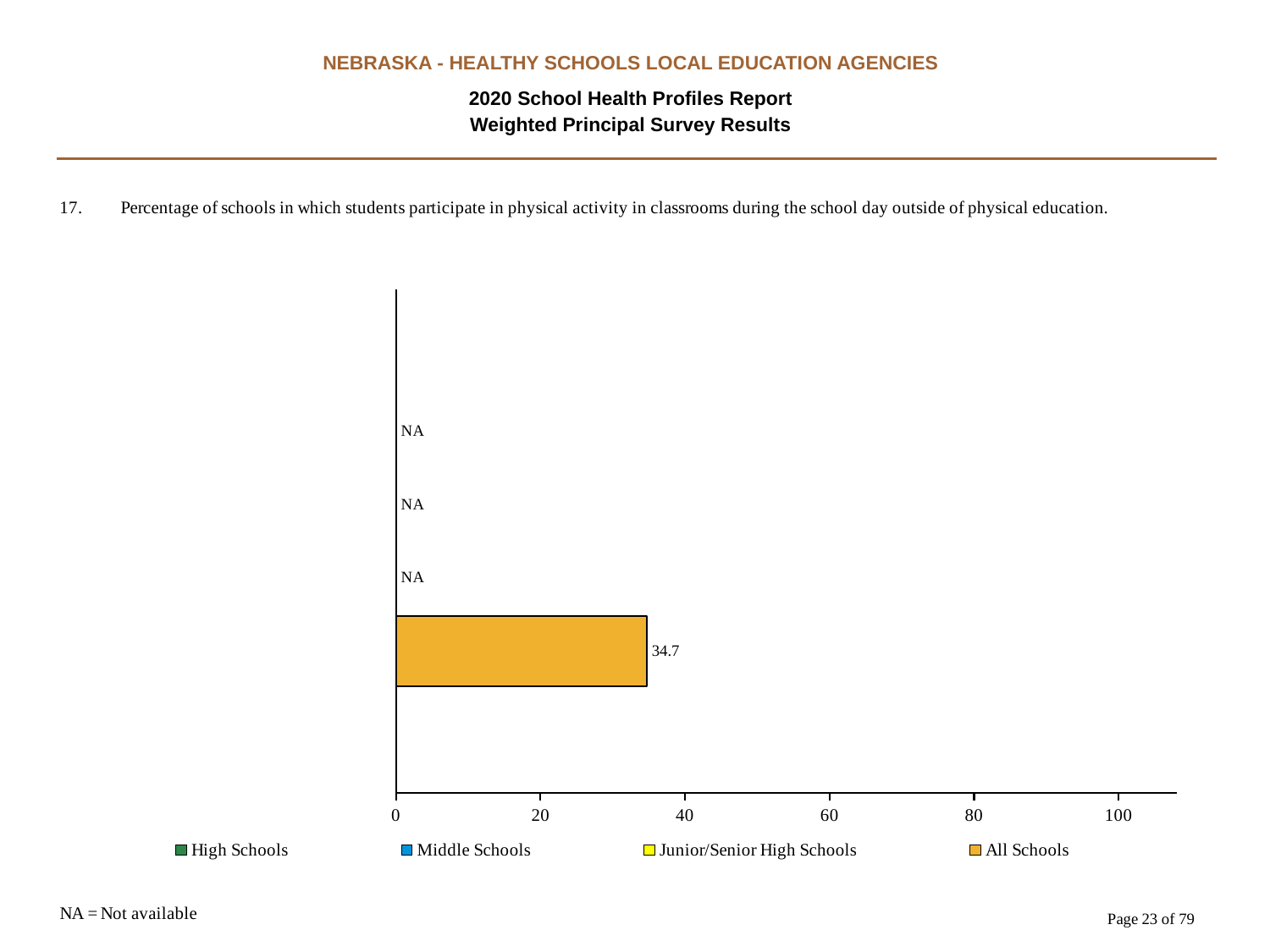
What kind of chart is shown on the slide? bar chart What is shown for Middle Schools on the chart? NA What is the value for All Schools? 34.7 How many series have a plotted bar with a numeric value? 1 What is shown for Junior/Senior High Schools on the chart? NA What is shown for High Schools on the chart? NA How many series does the legend list? 4 What is the highest value shown on the x axis? 100 What does NA stand for according to the slide? Not available Is the value for All Schools greater or less than 20? greater Is the value for All Schools greater or less than 40? less